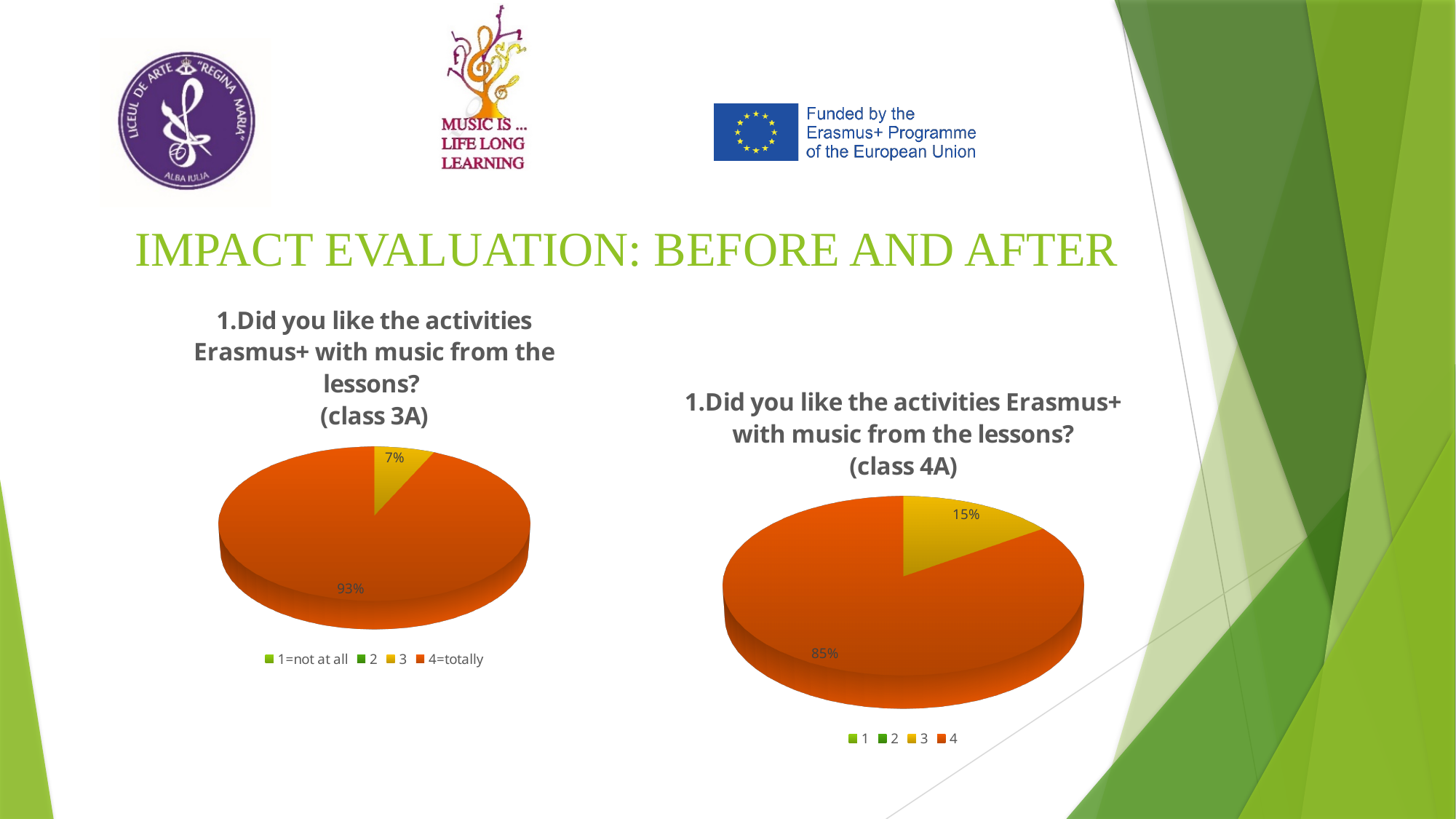
Which is larger: the share for 4 in the class 4A chart or the share for 4=totally in the class 3A chart? 4=totally in the class 3A chart How many entries does the legend of the class 4A chart list? 4 In the class 4A chart, what share of the pie is labelled 4? 85% What is the difference between the two slices shown in the class 4A chart? 70% What is the difference between the two slices shown in the class 3A chart? 86% In the class 3A chart, what share of the pie is labelled 4=totally? 93% In the class 3A chart, what share of the pie is labelled 3? 7% What type of chart is used for the class 3A data? Pie chart In the class 4A chart, which category has the smallest visible slice? 3 In the class 3A chart, what colour is the slice labelled 93%? Orange In the class 3A chart, which category has the largest slice? 4=totally